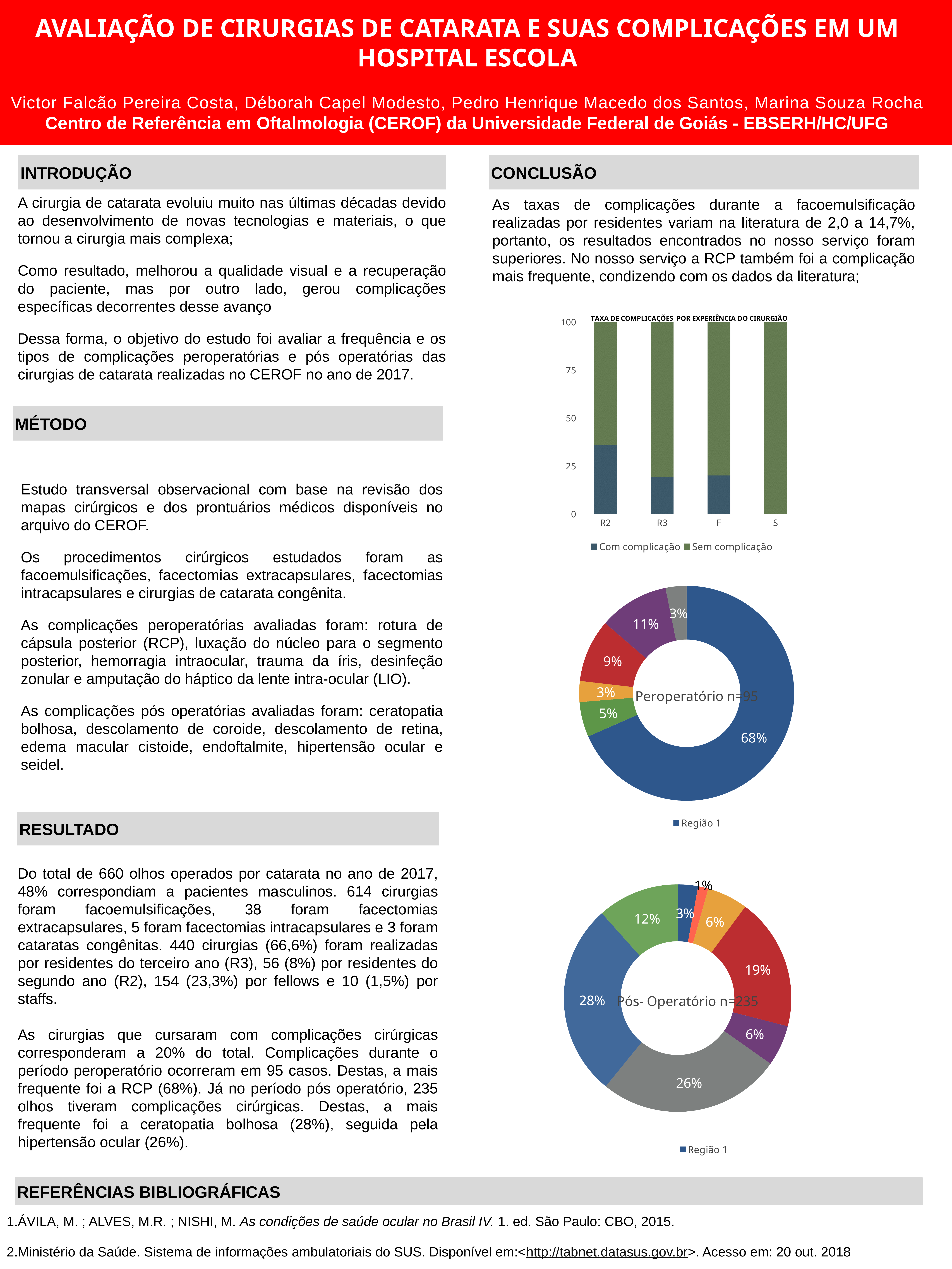
In the bar chart 'TAXA DE COMPLICAÇÕES POR EXPERIÊNCIA DO CIRURGIÃO', how many categories are shown on the x axis? 4 In the bar chart 'TAXA DE COMPLICAÇÕES POR EXPERIÊNCIA DO CIRURGIÃO', is the 'Com complicação' value for R3 greater or less than 25? less In the bar chart 'TAXA DE COMPLICAÇÕES POR EXPERIÊNCIA DO CIRURGIÃO', which category has the highest 'Com complicação' value? R2 In the doughnut chart 'Peroperatório n=95', what is the share of the largest slice? 68% What is the title of the bar chart on the slide? TAXA DE COMPLICAÇÕES POR EXPERIÊNCIA DO CIRURGIÃO In the doughnut chart 'Pós- Operatório n=235', what is the share of the largest slice? 28% In the bar chart 'TAXA DE COMPLICAÇÕES POR EXPERIÊNCIA DO CIRURGIÃO', which category has the lowest 'Com complicação' value? S In the bar chart 'TAXA DE COMPLICAÇÕES POR EXPERIÊNCIA DO CIRURGIÃO', is the 'Com complicação' value for R2 greater or less than 25? greater What kind of chart is 'TAXA DE COMPLICAÇÕES POR EXPERIÊNCIA DO CIRURGIÃO'? Stacked bar chart In the doughnut chart 'Pós- Operatório n=235', what is the difference between the two largest slices (28% and 26%)? 2% In the doughnut chart 'Peroperatório n=95', how many slices are there? 6 In the bar chart 'TAXA DE COMPLICAÇÕES POR EXPERIÊNCIA DO CIRURGIÃO', how many series does the legend list? 2